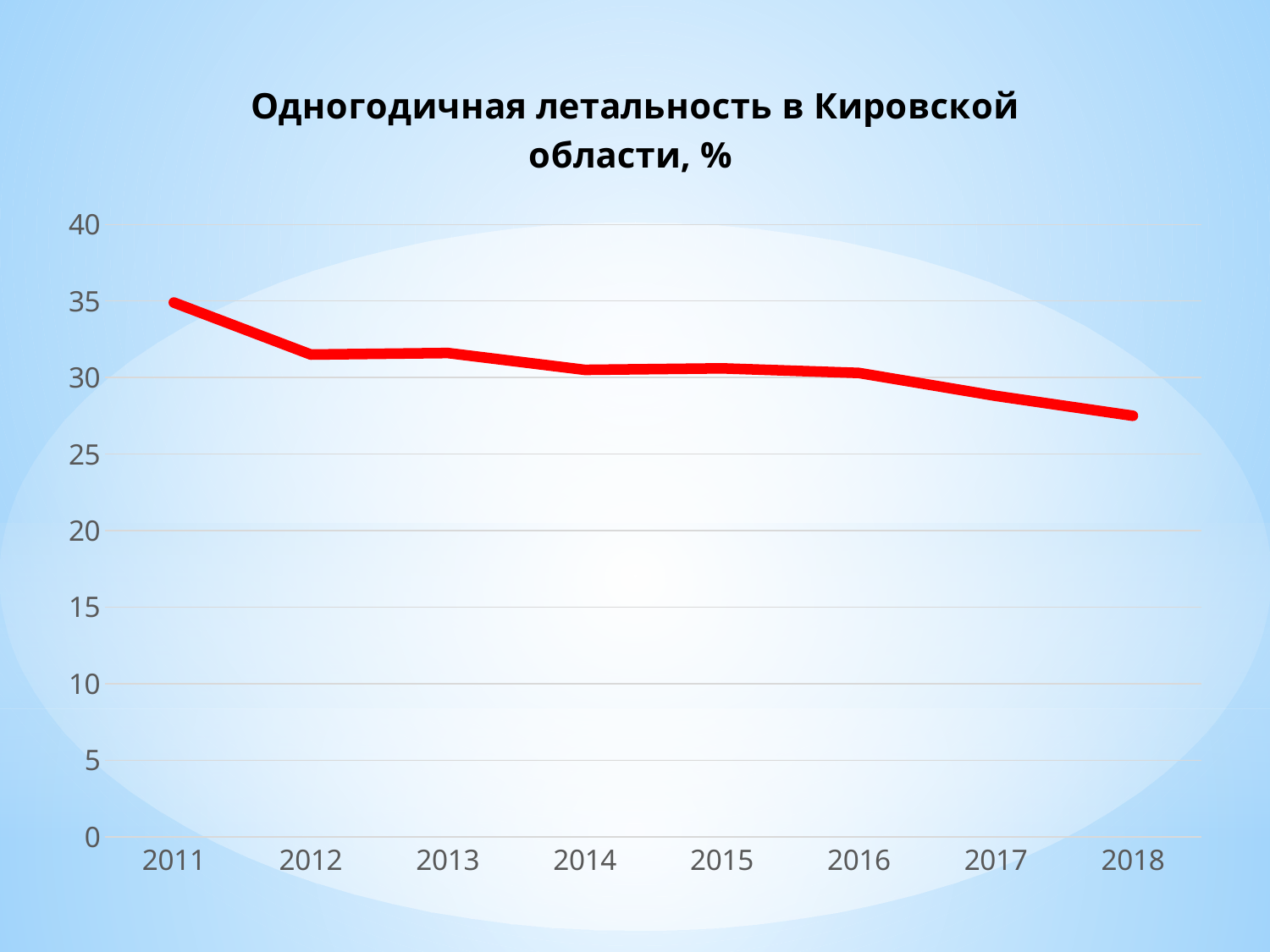
Is the value for 2018 greater or less than 30? less What kind of chart is shown on the slide? line chart Is the value for 2011 greater or less than 30? greater Which year has the highest value? 2011 What is the title of the chart? Одногодичная летальность в Кировской области, % Which year has the lowest value? 2018 Do the values generally rise or fall from 2011 to 2018? fall Is the value for 2013 greater or less than 35? less How many years are plotted on the x axis? 8 Which is larger, the value for 2011 or the value for 2018? 2011 What colour is the plotted line? red